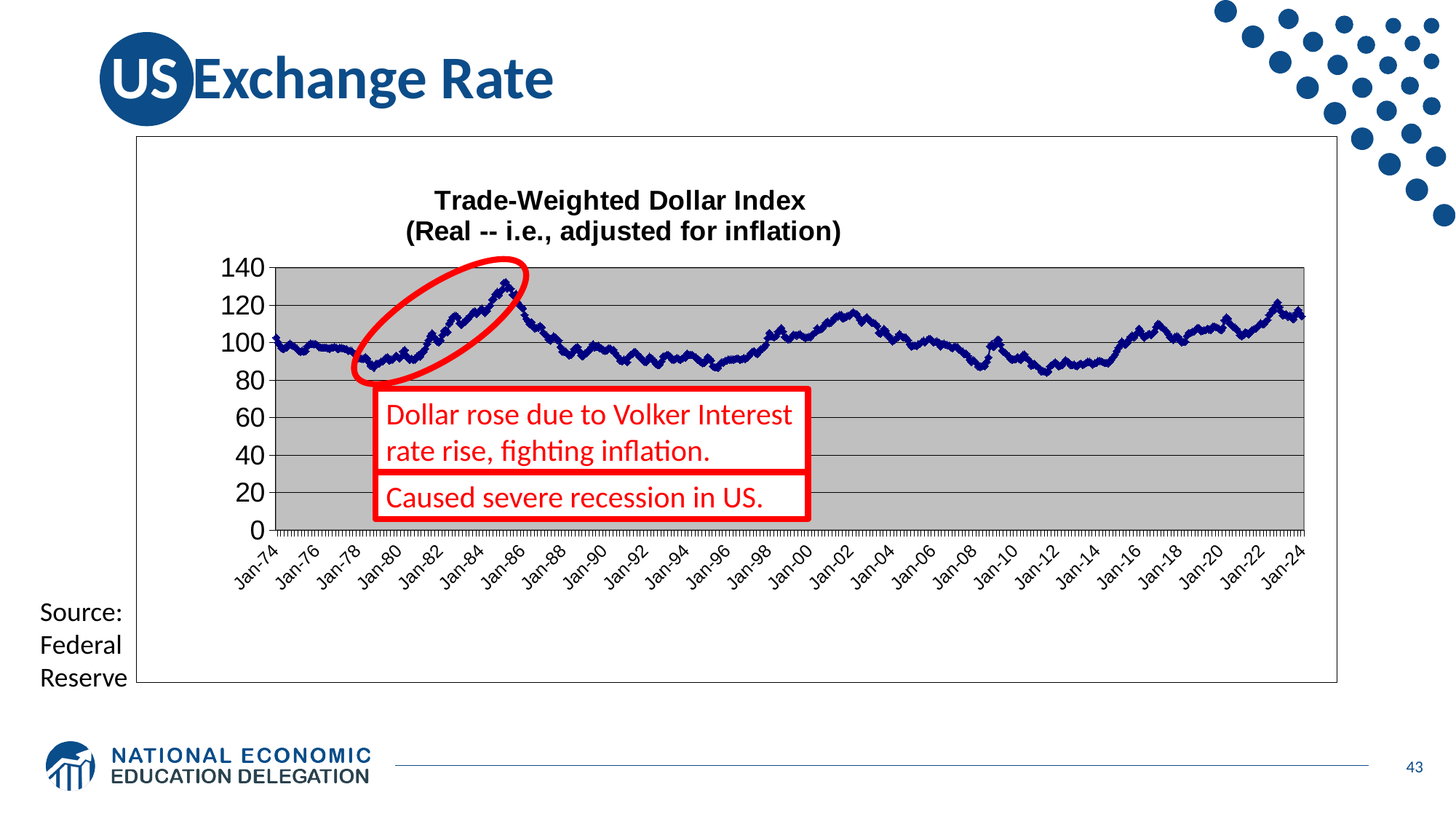
What is the title of the chart? Trade-Weighted Dollar Index (Real -- i.e., adjusted for inflation) Is the value of the Trade-Weighted Dollar Index at Jan-12 greater or less than 100? less Which is higher, the Trade-Weighted Dollar Index at Jan-02 or at Jan-12? Jan-02 Does the Trade-Weighted Dollar Index rise or fall between Jan-86 and Jan-88? fall Is the value of the Trade-Weighted Dollar Index at Jan-02 greater or less than 100? greater Is the value of the Trade-Weighted Dollar Index at its peak around 1985 greater or less than 120? greater Does the Trade-Weighted Dollar Index rise or fall between Jan-80 and Jan-85? rise What type of chart is shown on the slide? line chart How many date labels are shown on the horizontal axis of the chart? 26 What is the highest value shown on the vertical axis of the chart? 140